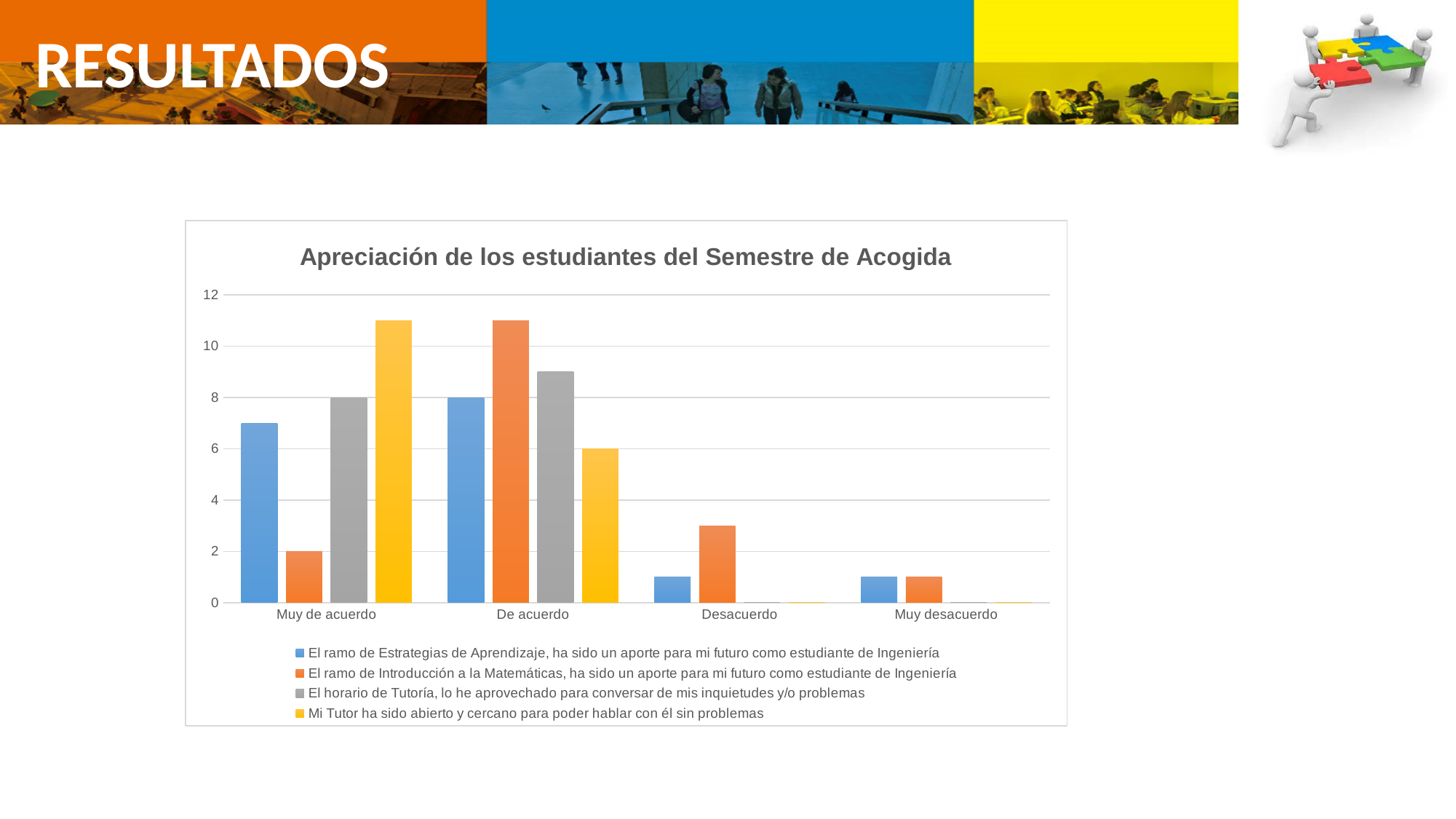
What is the value for 'Mi Tutor ha sido abierto y cercano' in the 'De acuerdo' category? 6 In the 'Muy de acuerdo' category, which is larger: 'El ramo de Estrategias de Aprendizaje' or 'El horario de Tutoría'? El horario de Tutoría Which series has the highest value in the 'Muy de acuerdo' category? Mi Tutor ha sido abierto y cercano para poder hablar con él sin problemas Is the value for 'El ramo de Introducción a la Matemáticas' in the 'De acuerdo' category greater or less than 10? greater How many series does the legend list? 4 What is the value for 'El horario de Tutoría' in the 'Muy de acuerdo' category? 8 What type of chart is shown on the slide? Bar chart What is the value for 'El ramo de Introducción a la Matemáticas' in the 'Muy de acuerdo' category? 2 What is the title of the chart? Apreciación de los estudiantes del Semestre de Acogida What is the difference between 'El ramo de Estrategias de Aprendizaje' and 'Mi Tutor ha sido abierto y cercano' in the 'De acuerdo' category? 2 How many response categories are shown on the x axis? 4 Which series has the lowest value in the 'Muy de acuerdo' category? El ramo de Introducción a la Matemáticas, ha sido un aporte para mi futuro como estudiante de Ingeniería